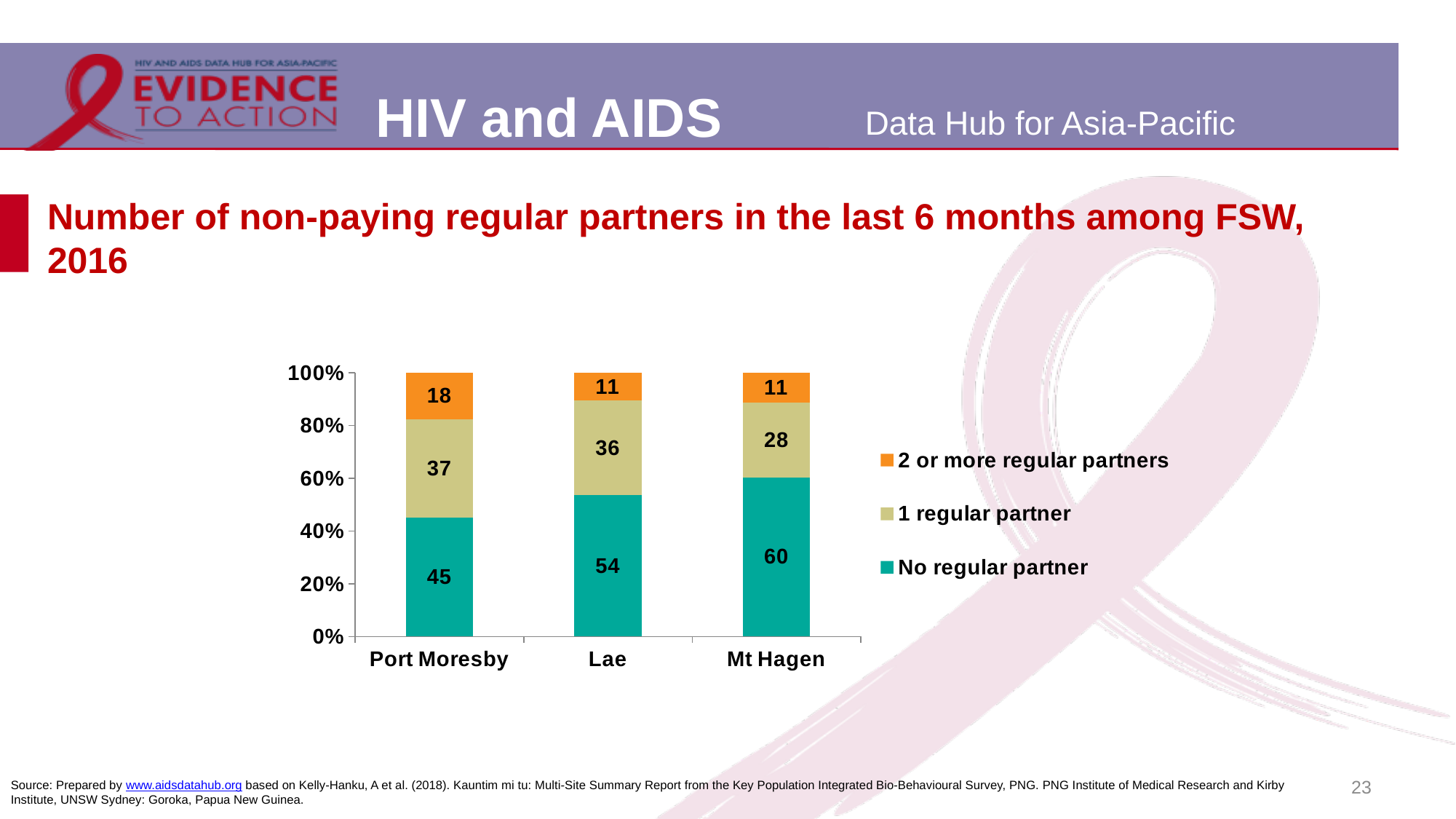
What is the value for '2 or more regular partners' in Mt Hagen? 11 Which city has the highest value for 'No regular partner'? Mt Hagen Do the 'No regular partner' values rise or fall from Port Moresby to Mt Hagen? Rise How many cities are shown on the x axis? 3 What is the value for 'No regular partner' in Port Moresby? 45 How many series does the legend list? 3 Which colour represents '2 or more regular partners' in the legend? Orange What kind of chart is shown on the slide? Stacked bar chart Which is larger: the '2 or more regular partners' value for Port Moresby or for Lae? Port Moresby What is the difference between the 'No regular partner' values for Mt Hagen and Port Moresby? 15 Which city has the lowest value for '1 regular partner'? Mt Hagen What is the value for '1 regular partner' in Lae? 36